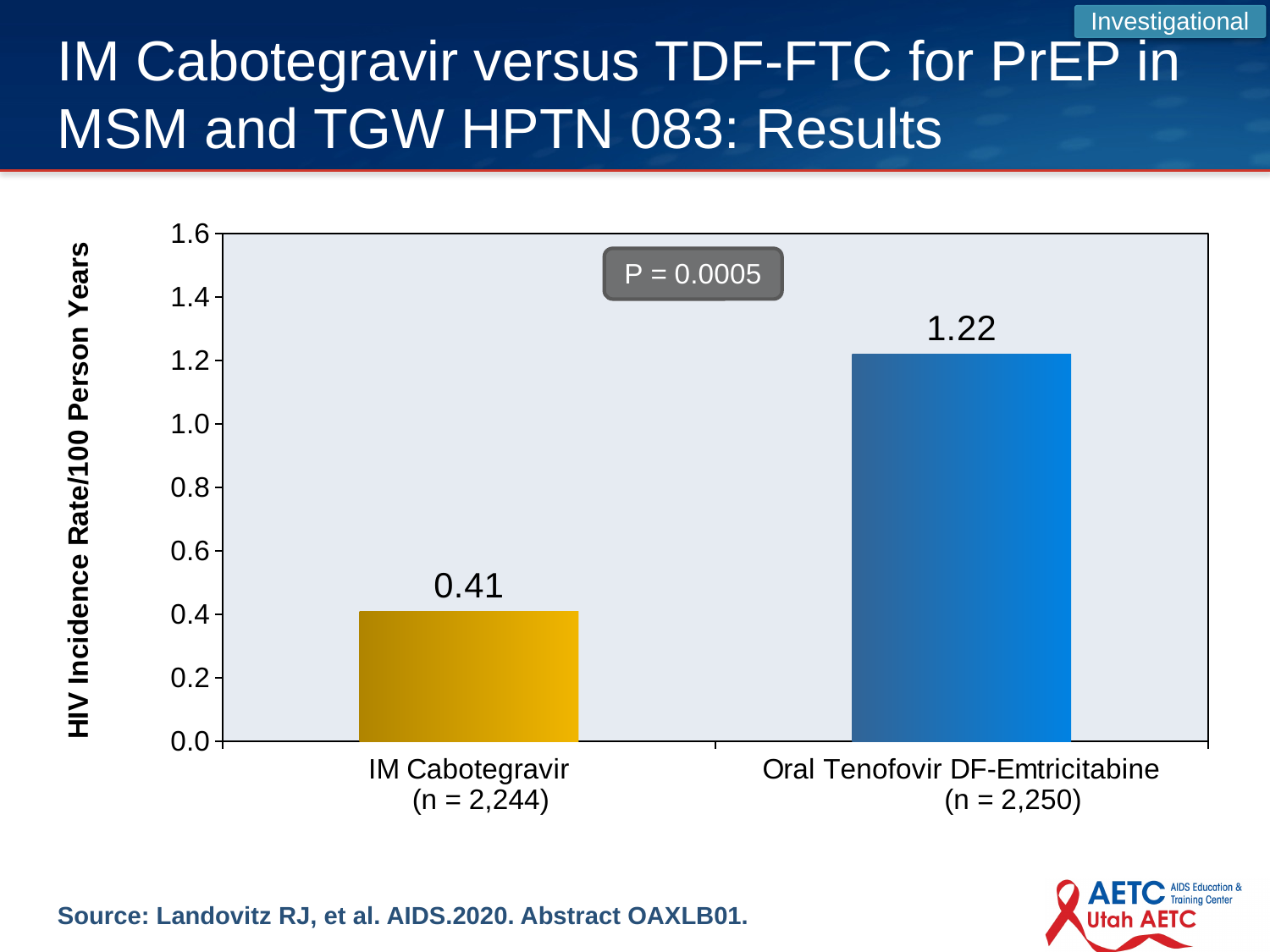
Which group has the lower HIV incidence rate? IM Cabotegravir Is the HIV incidence rate higher for IM Cabotegravir or for Oral Tenofovir DF-Emtricitabine? Oral Tenofovir DF-Emtricitabine Is the HIV incidence rate for IM Cabotegravir greater or less than 0.6? less Which group has the higher HIV incidence rate? Oral Tenofovir DF-Emtricitabine How many treatment groups are shown in the chart? 2 What is the difference in HIV incidence rate between Oral Tenofovir DF-Emtricitabine and IM Cabotegravir? 0.81 What P value is shown on the chart? P = 0.0005 What is the HIV incidence rate per 100 person years for Oral Tenofovir DF-Emtricitabine? 1.22 What is the HIV incidence rate per 100 person years for IM Cabotegravir? 0.41 Is the HIV incidence rate for Oral Tenofovir DF-Emtricitabine greater or less than 1.0? greater What type of chart is shown on the slide? Bar chart What is the label of the y-axis? HIV Incidence Rate/100 Person Years